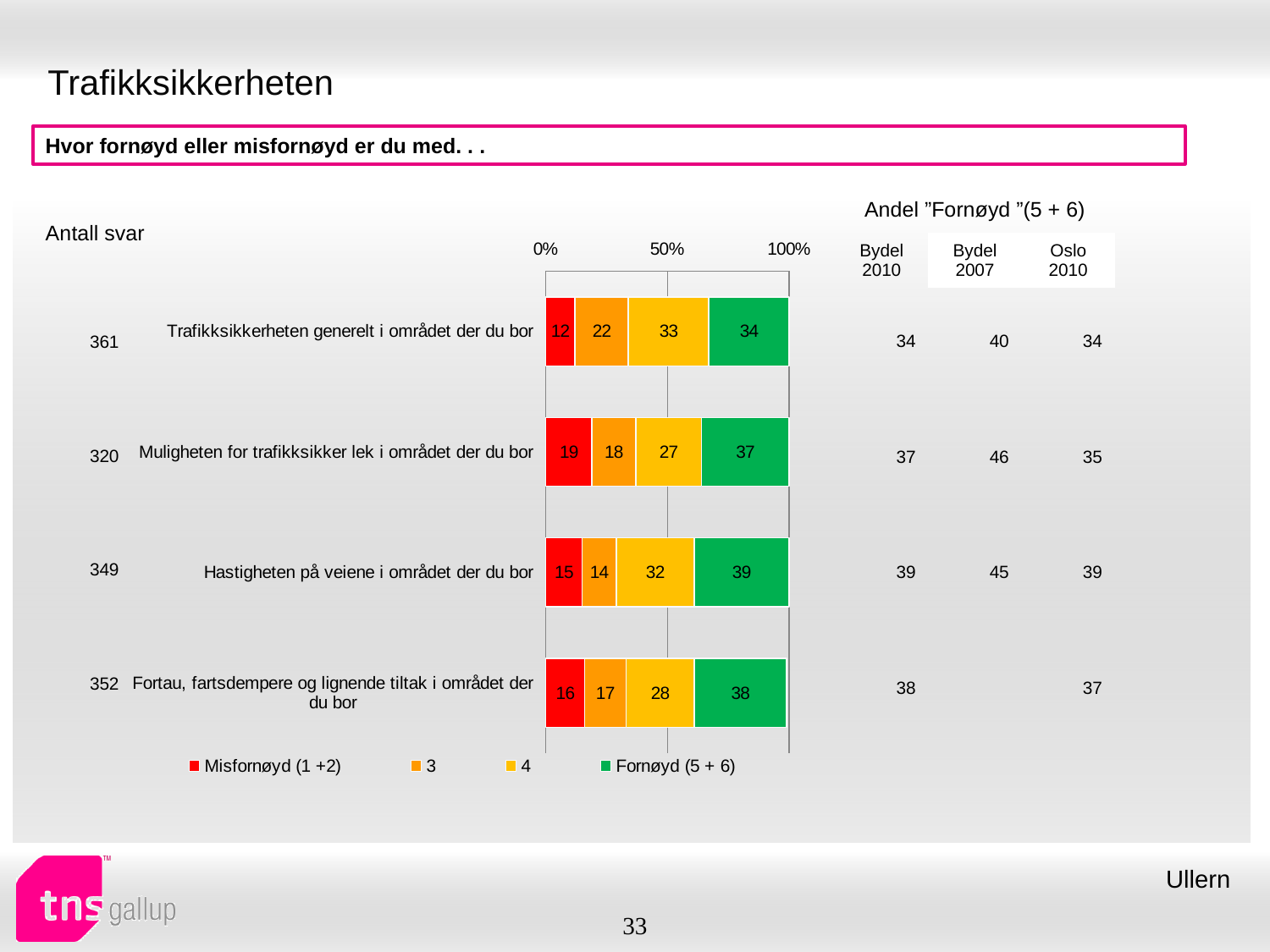
What kind of chart is shown on the slide? Stacked bar chart Which has the larger Misfornøyd (1 +2) value: "Muligheten for trafikksikker lek i området der du bor" or "Fortau, fartsdempere og lignende tiltak i området der du bor"? Muligheten for trafikksikker lek i området der du bor What is the value of the Misfornøyd (1 +2) segment for "Muligheten for trafikksikker lek i området der du bor"? 19 How many series does the legend list? 4 What is the value of the Fornøyd (5 + 6) segment for "Hastigheten på veiene i området der du bor"? 39 Which category has the highest Fornøyd (5 + 6) value? Hastigheten på veiene i området der du bor For "Trafikksikkerheten generelt i området der du bor", what is the difference between the Fornøyd (5 + 6) value and the Misfornøyd (1 +2) value? 22 How many categories are shown in the chart? 4 What is the first entry in the chart's legend? Misfornøyd (1 +2) Which category has the lowest Misfornøyd (1 +2) value? Trafikksikkerheten generelt i området der du bor What is the value of the "4" segment for "Fortau, fartsdempere og lignende tiltak i området der du bor"? 28 What is the difference between the "3" segment for "Trafikksikkerheten generelt i området der du bor" and the "3" segment for "Hastigheten på veiene i området der du bor"? 8